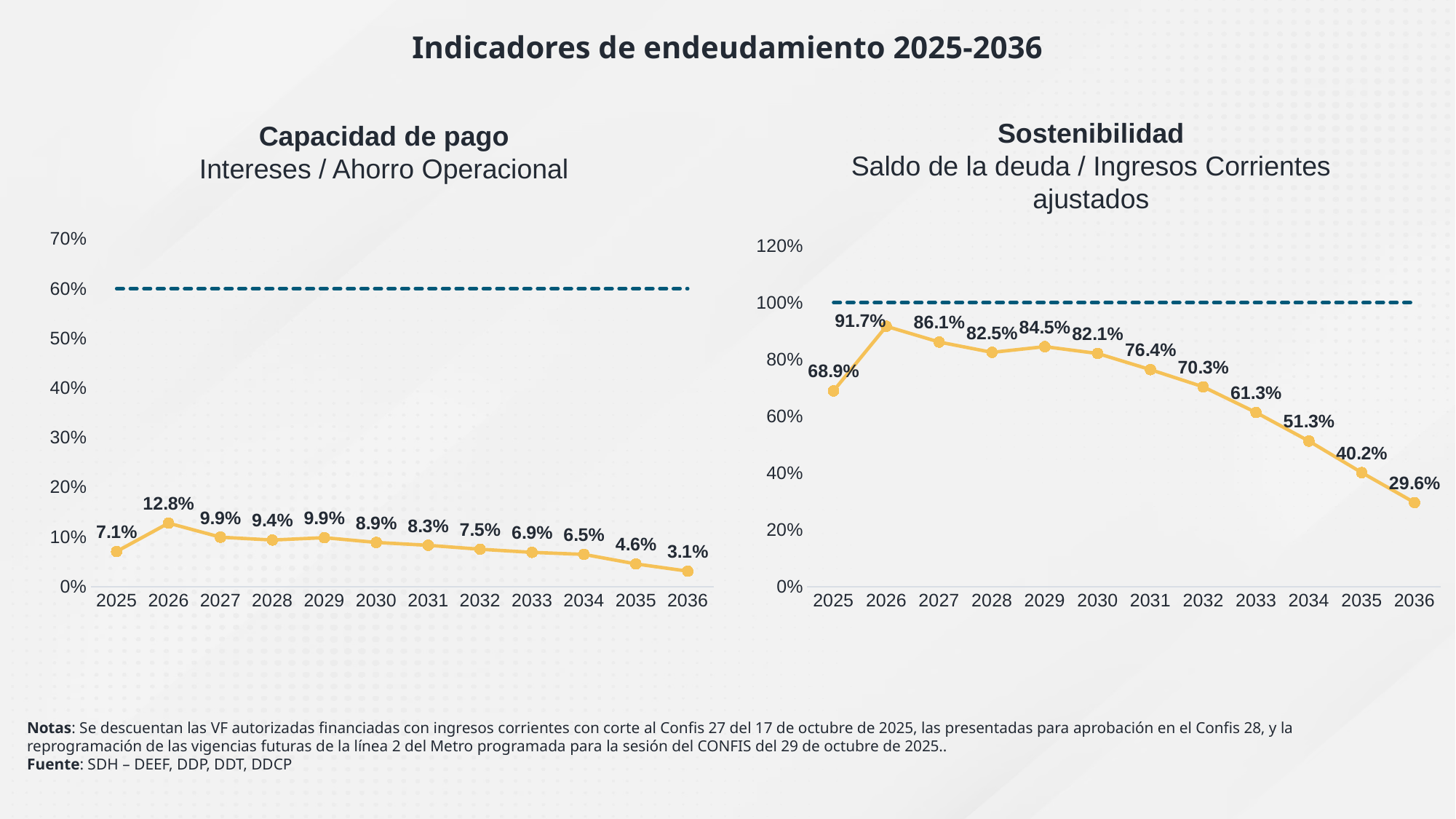
How many years are plotted in the 'Sostenibilidad' chart? 12 In the 'Capacidad de pago' chart, which year has the lowest value? 2036 In the 'Capacidad de pago' chart, what is the difference between the 2026 value and the 2025 value? 5.7% In the 'Capacidad de pago' chart, what is the value for 2036? 3.1% In the 'Sostenibilidad' chart, what is the value for 2029? 84.5% In the 'Sostenibilidad' chart, what is the difference between the 2026 value and the 2036 value? 62.1% In the 'Capacidad de pago' chart, what is the value for 2026? 12.8% In the 'Sostenibilidad' chart, which year has the highest value? 2026 In the 'Sostenibilidad' chart, which year has the lowest value? 2036 In the 'Capacidad de pago' chart, which year has the highest value? 2026 In the 'Sostenibilidad' chart, which is larger, the value for 2027 or the value for 2030? 2027 What kind of chart is the 'Capacidad de pago' chart? Line chart